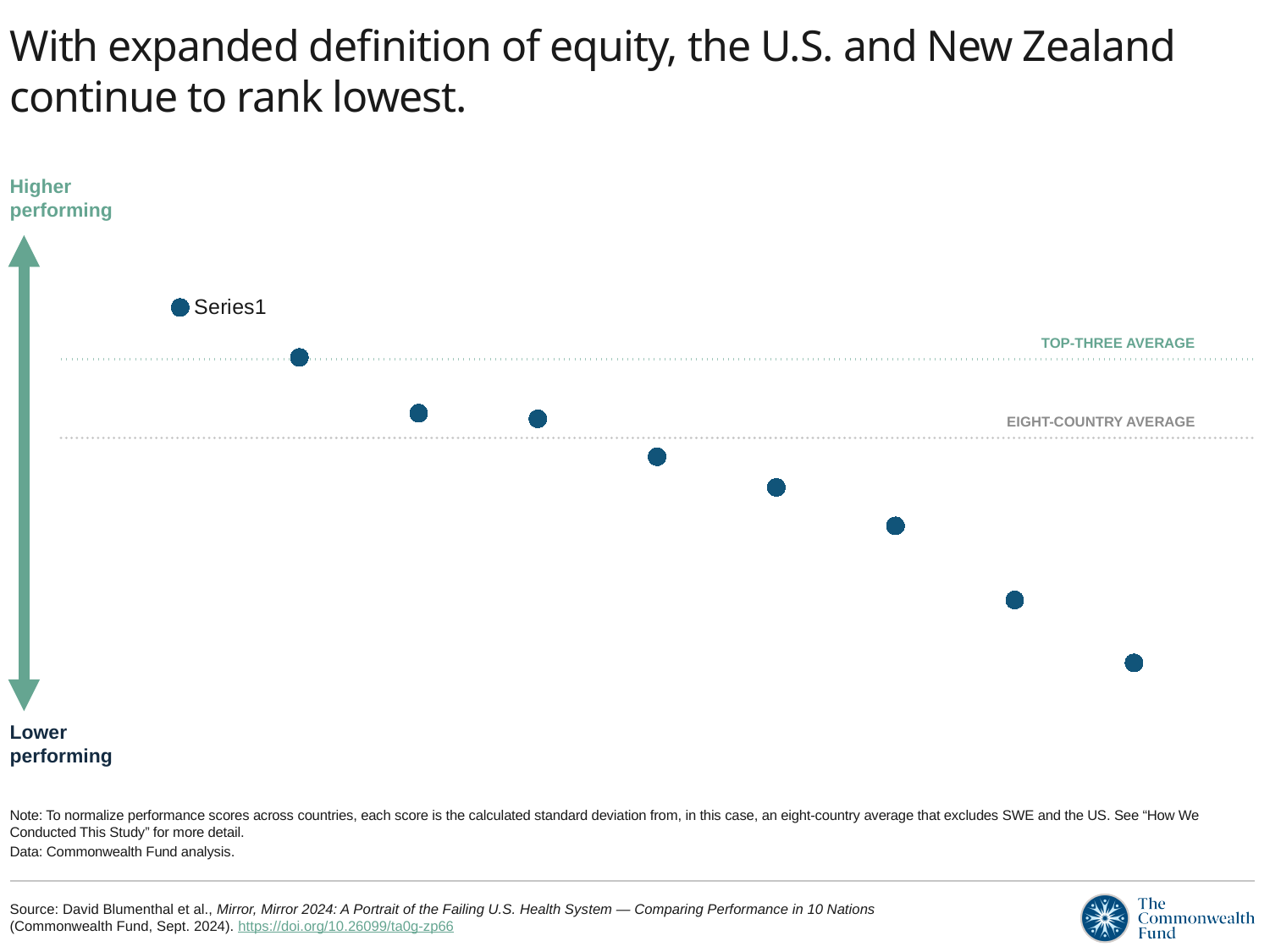
What are the two reference lines on the chart labelled? TOP-THREE AVERAGE and EIGHT-COUNTRY AVERAGE Do the plotted values rise or fall from left to right across the chart? Fall What is the name of the series shown in the chart legend? Series1 How many series does the chart legend list? 1 Is the leftmost plotted point higher or lower than the rightmost plotted point? Higher Which end of the vertical axis is labelled 'Higher performing', the top or the bottom? Top How many plotted points lie above the EIGHT-COUNTRY AVERAGE line? 4 How many data points are plotted on the chart? 9 What kind of chart is shown on the slide? Scatter (dot) chart